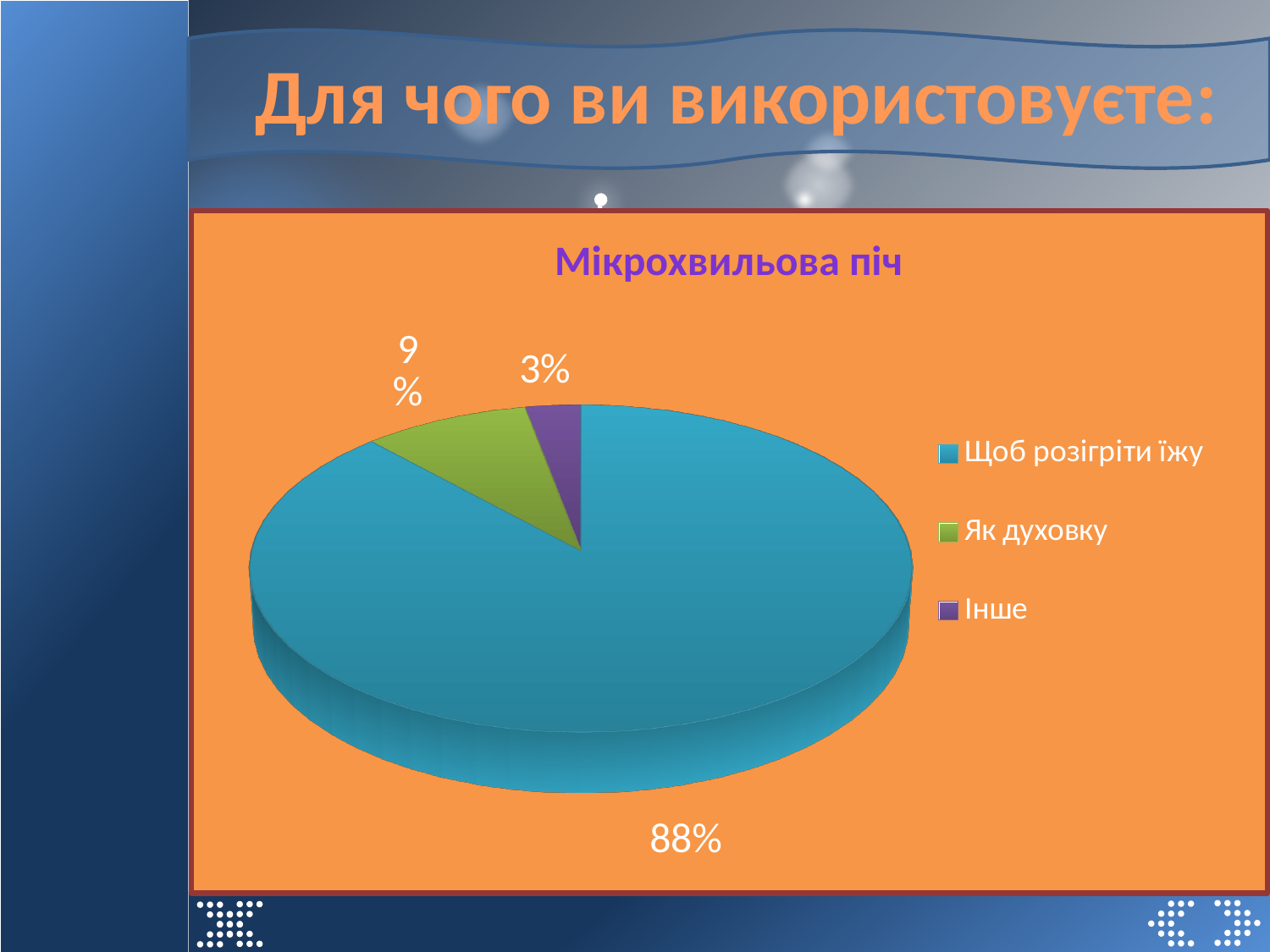
What is the title of the chart? Мікрохвильова піч What share of the pie does "Як духовку" take? 9% Which category has the largest slice of the pie? Щоб розігріти їжу What colour is the slice for "Інше"? purple What kind of chart is shown on the slide? pie chart Which is larger, the slice for "Як духовку" or the slice for "Інше"? Як духовку Which category has the smallest slice of the pie? Інше What share of the pie does "Інше" take? 3% What share of the pie does "Щоб розігріти їжу" take? 88% What is the difference in percentage points between "Щоб розігріти їжу" and "Як духовку"? 79 How many slices does the pie chart have? 3 How many entries does the legend list? 3